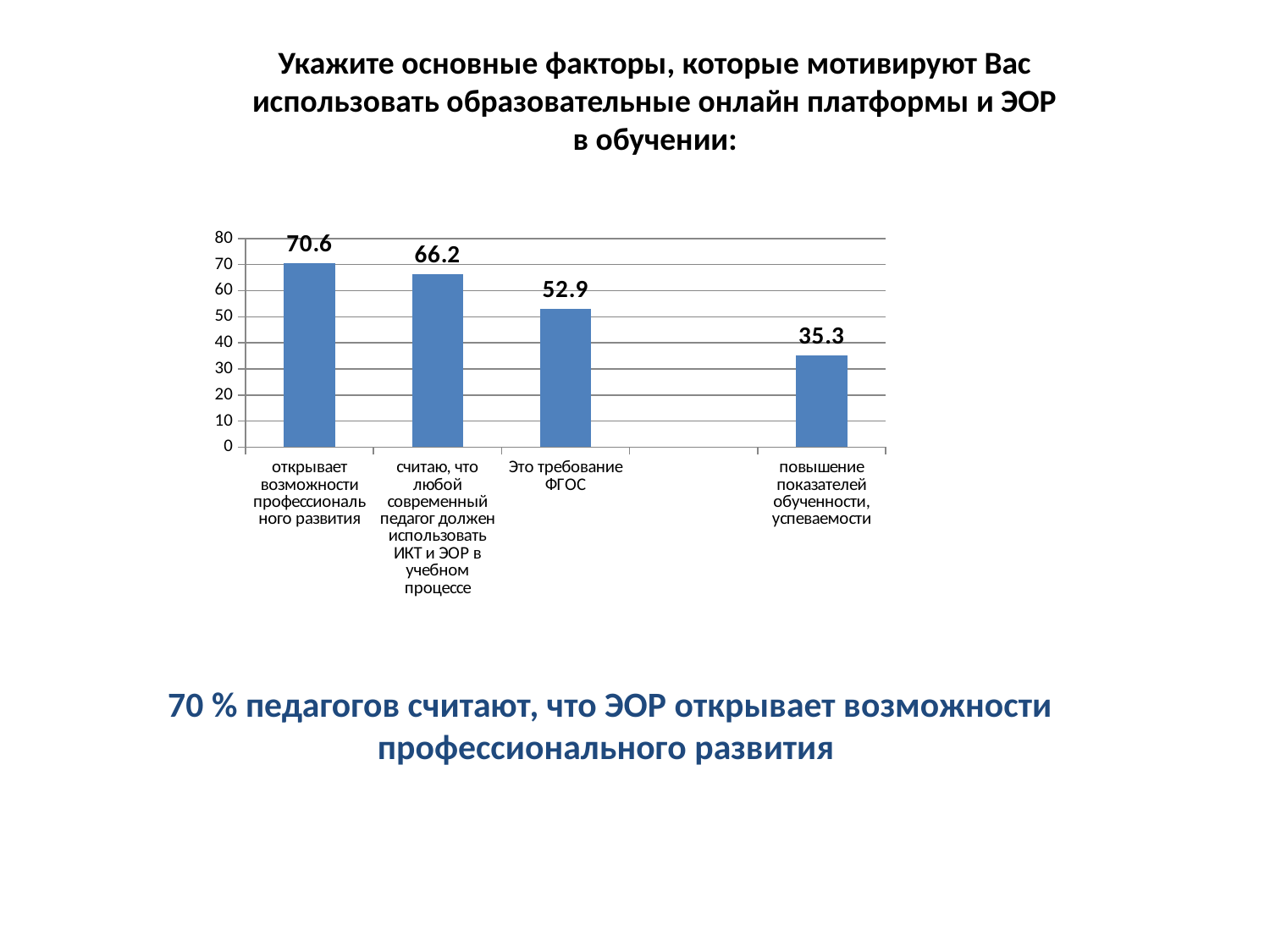
Which is larger: the value for "Это требование ФГОС" or the value for "повышение показателей обученности, успеваемости"? Это требование ФГОС What is the value for "Это требование ФГОС"? 52.9 What is the difference between the values for "открывает возможности профессионального развития" and "повышение показателей обученности, успеваемости"? 35.3 Do the values rise or fall from left to right along the x axis? fall What is the difference between the values for "считаю, что любой современный педагог должен использовать ИКТ и ЭОР в учебном процессе" and "Это требование ФГОС"? 13.3 Which category has the lowest value? повышение показателей обученности, успеваемости Which category has the highest value? открывает возможности профессионального развития What kind of chart is shown on the slide? bar chart What is the value for "повышение показателей обученности, успеваемости"? 35.3 Is the value for "считаю, что любой современный педагог должен использовать ИКТ и ЭОР в учебном процессе" greater or less than 60? greater How many categories are shown in the chart? 4 What is the value for "открывает возможности профессионального развития"? 70.6